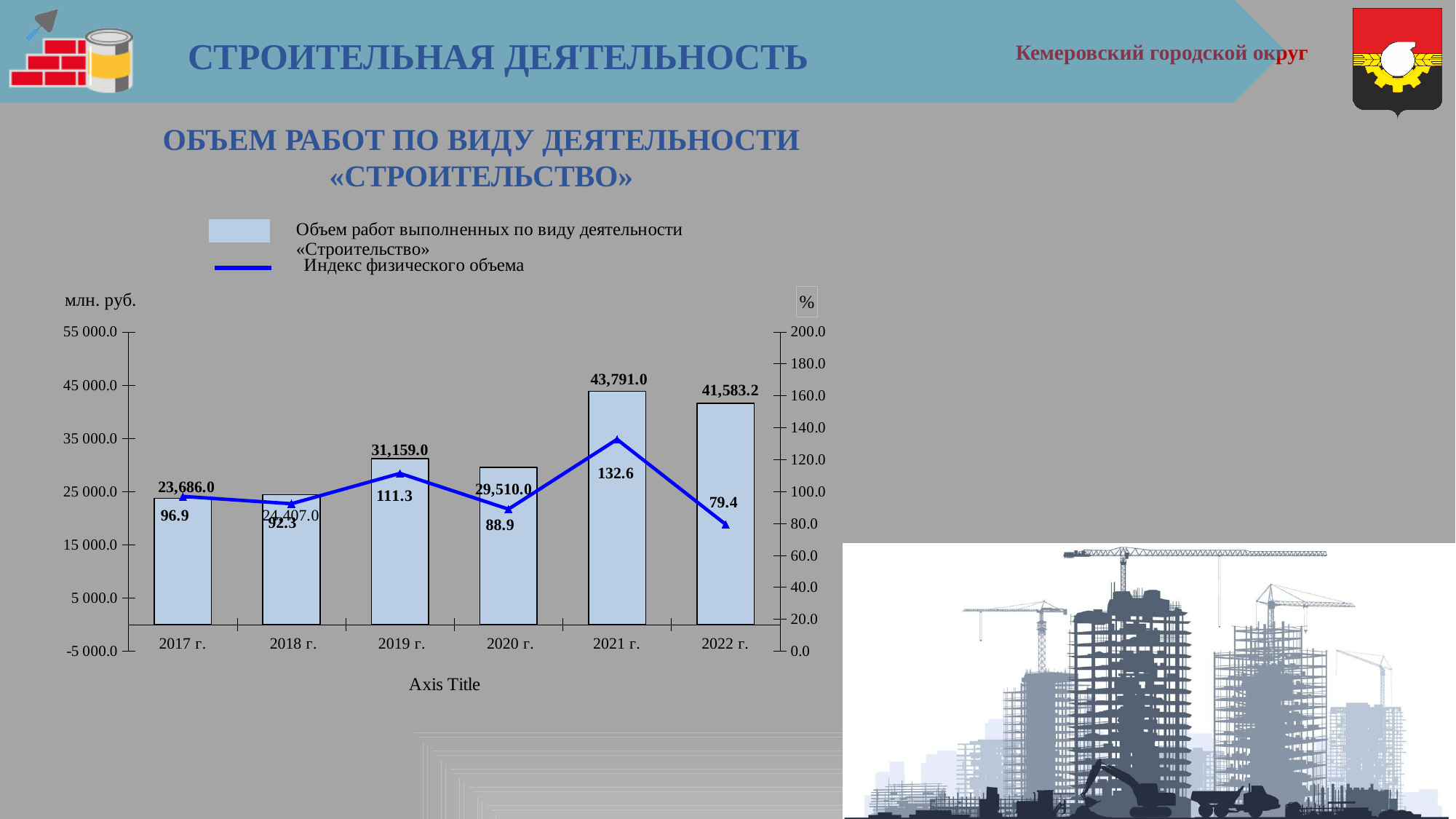
How many series does the legend list? 2 Which year has the highest volume of work? 2021 г. Which year has the larger volume of work, 2019 г. or 2020 г.? 2019 г. Which year has the lowest physical volume index? 2022 г. Is the physical volume index for 2021 г. greater or less than 120.0? greater What is the volume of work for 2021 г.? 43,791.0 What is the physical volume index (Индекс физического объема) for 2019 г.? 111.3 Does the physical volume index rise or fall from 2021 г. to 2022 г.? fall What is the volume of work for 2022 г.? 41,583.2 What unit is shown on the left vertical axis? млн. руб. How many years are shown on the x axis? 6 What is the difference in volume of work between 2021 г. and 2022 г.? 2,207.8